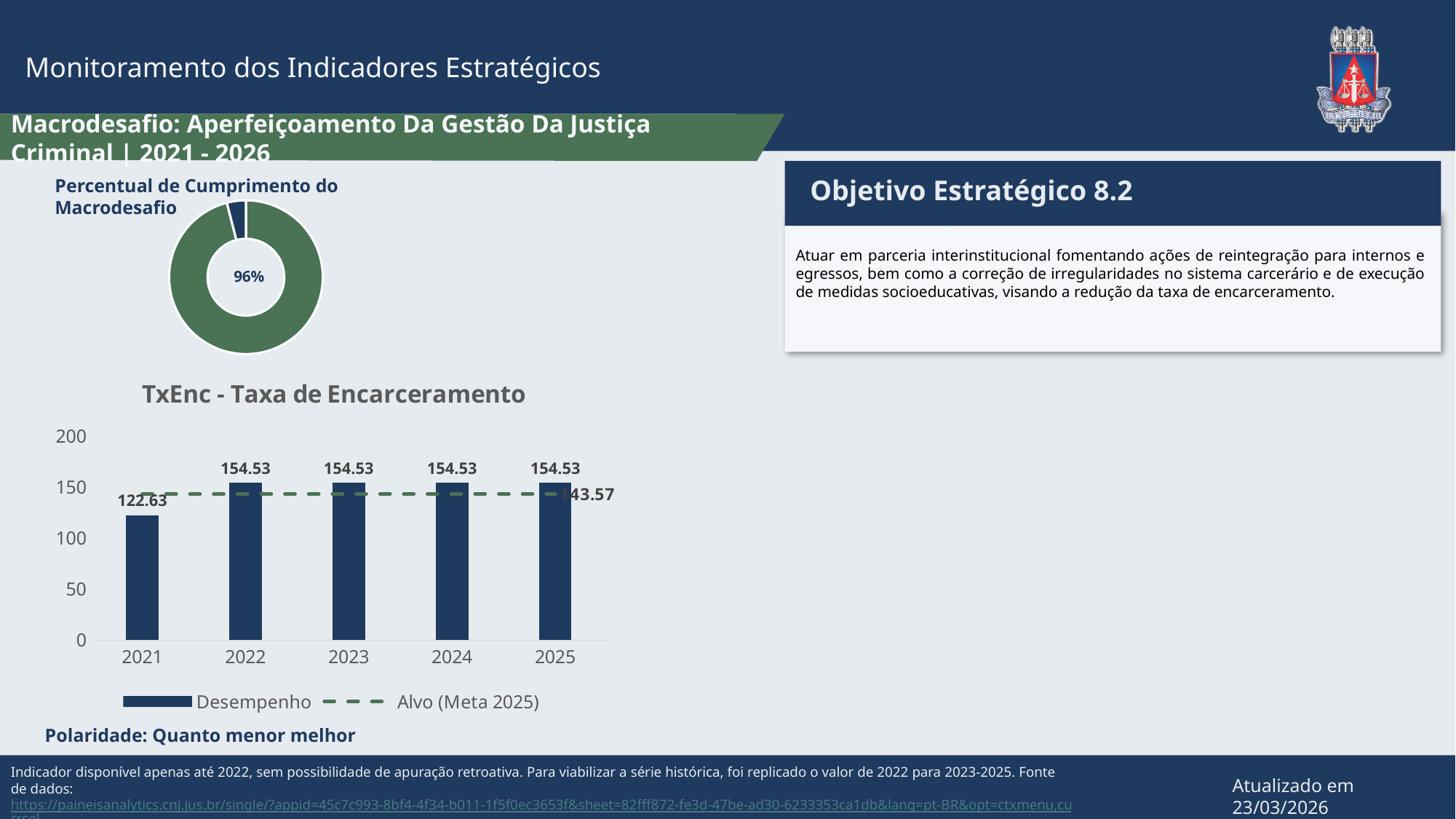
In the 'TxEnc - Taxa de Encarceramento' chart, what is the Desempenho value for 2023? 154.53 In the 'TxEnc - Taxa de Encarceramento' chart, what is the difference between the Desempenho values for 2022 and 2021? 31.90 In the 'TxEnc - Taxa de Encarceramento' chart, what is the value of the Alvo (Meta 2025) line? 143.57 In the 'TxEnc - Taxa de Encarceramento' chart, what is the Desempenho value for 2021? 122.63 In the 'TxEnc - Taxa de Encarceramento' chart, is the Desempenho value for 2025 larger or smaller than the Alvo (Meta 2025) value? larger How many years are shown on the x axis of the 'TxEnc - Taxa de Encarceramento' chart? 5 What kind of chart is 'TxEnc - Taxa de Encarceramento'? Combination bar and line chart In the 'TxEnc - Taxa de Encarceramento' chart, do the Desempenho values rise or fall from 2021 to 2022? Rise In the 'TxEnc - Taxa de Encarceramento' chart, which year has the lowest Desempenho value? 2021 How many series does the legend of the 'TxEnc - Taxa de Encarceramento' chart list? 2 In the 'TxEnc - Taxa de Encarceramento' chart, is the Desempenho value for 2021 greater or less than 150? less What percentage is shown in the centre of the 'Percentual de Cumprimento do Macrodesafio' donut chart? 96%